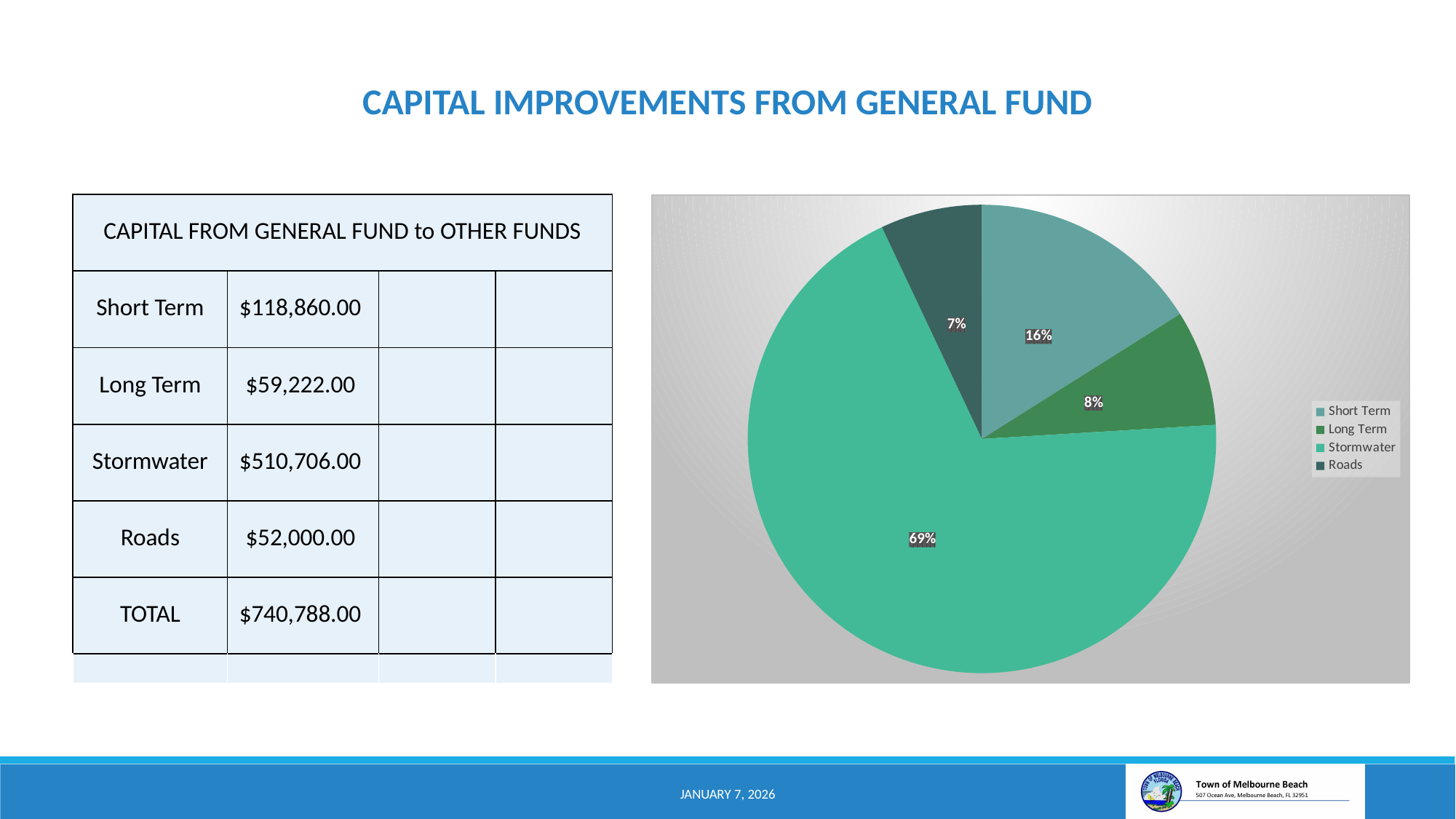
What percentage of the pie chart does Short Term represent? 16% Which category has the smallest slice in the pie chart? Roads What percentage of the pie chart does Stormwater represent? 69% What percentage of the pie chart does Roads represent? 7% What kind of chart is shown on the slide? pie chart Which legend entry in the pie chart is listed first? Short Term How many entries does the pie chart legend list? 4 Which slice is larger in the pie chart, Short Term or Long Term? Short Term What is the difference in percentage points between the Stormwater slice and the Short Term slice? 53 Which category has the largest slice in the pie chart? Stormwater How many slices does the pie chart have? 4